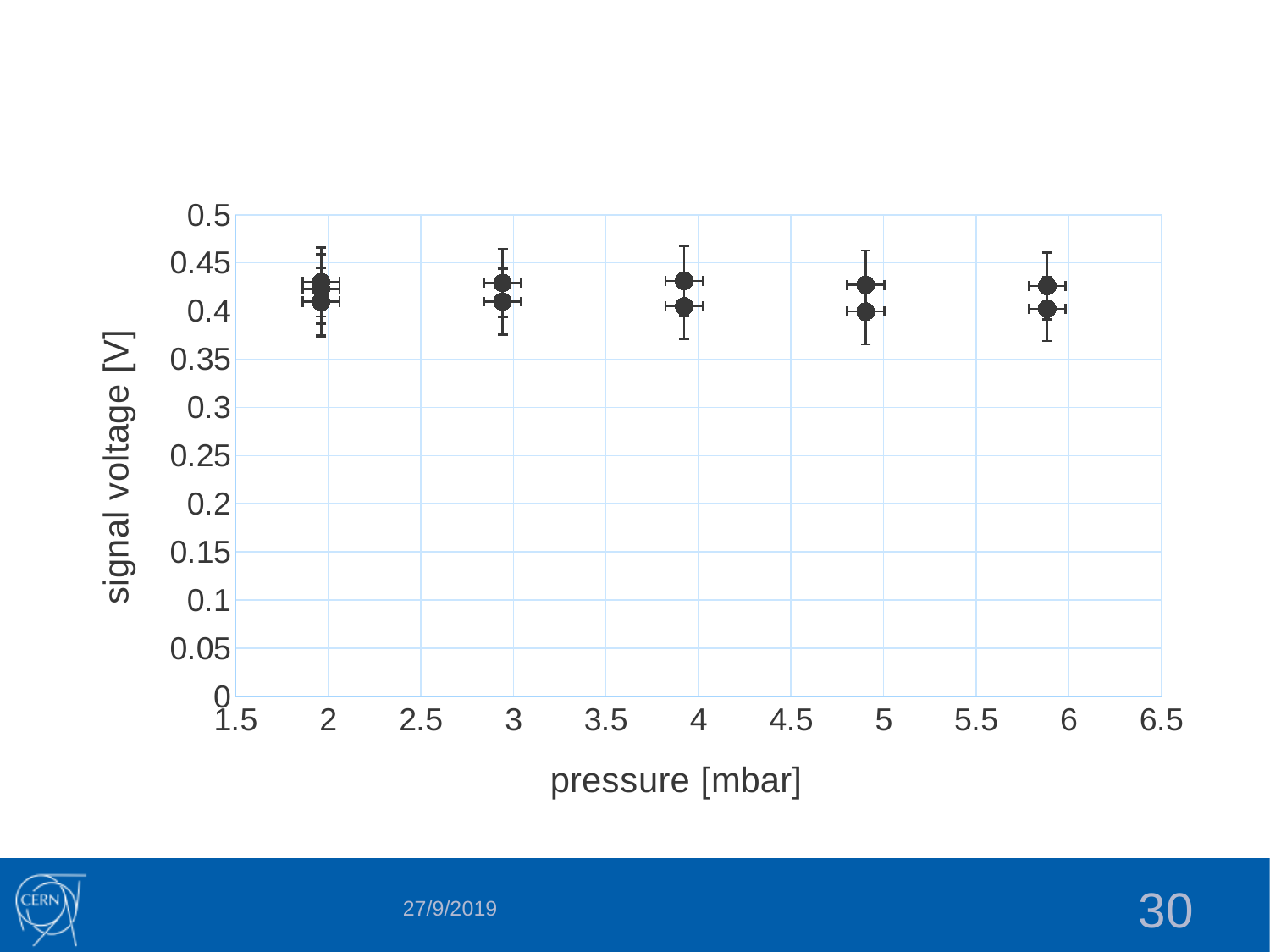
What kind of chart is shown on the slide? scatter plot As pressure increases from 2 to 6 mbar, does the signal voltage rise strongly, fall strongly, or stay roughly flat? roughly flat Are all plotted signal voltages greater or less than 0.25? greater Is the signal voltage at a pressure of about 2 mbar greater or less than 0.35? greater How many distinct pressure values have data points plotted? 5 Is the signal voltage at a pressure of about 5 mbar greater or less than 0.45? less What is the label of the y axis? signal voltage [V] What is the label of the x axis? pressure [mbar]